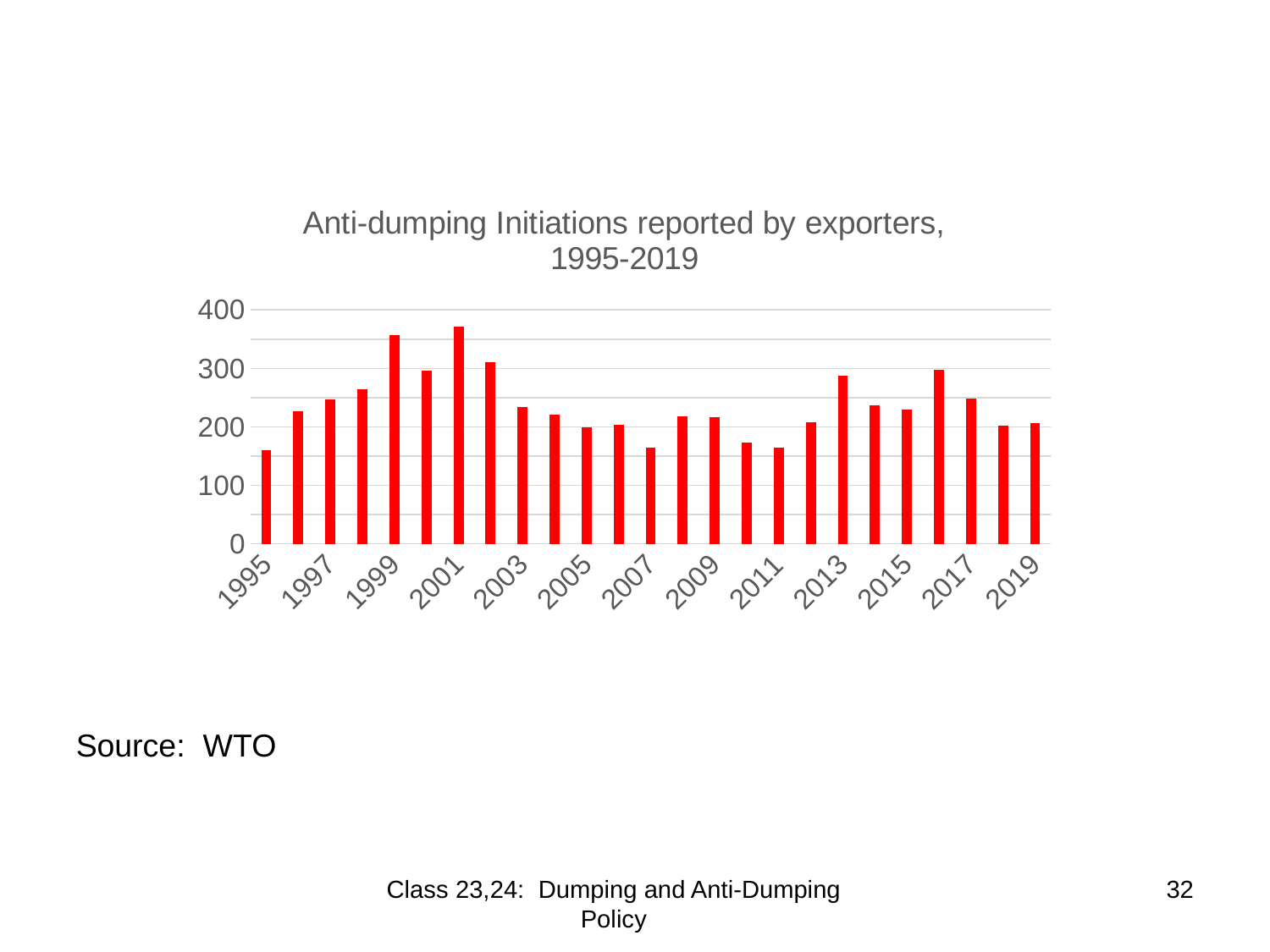
Do the values generally rise or fall from 1995 to 2001? rise Is the value for 2007 greater or less than 200? less What is the title of the chart? Anti-dumping Initiations reported by exporters, 1995-2019 How many bars (years) are plotted in the chart? 25 Is the value for 2001 greater or less than 300? greater What colour are the bars in the chart? red Which year has the larger value, 2001 or 2007? 2001 Is the value for 2013 greater or less than 200? greater What kind of chart is shown on the slide? bar chart Which year has the highest number of anti-dumping initiations? 2001 Which year has the larger value, 1999 or 2013? 1999